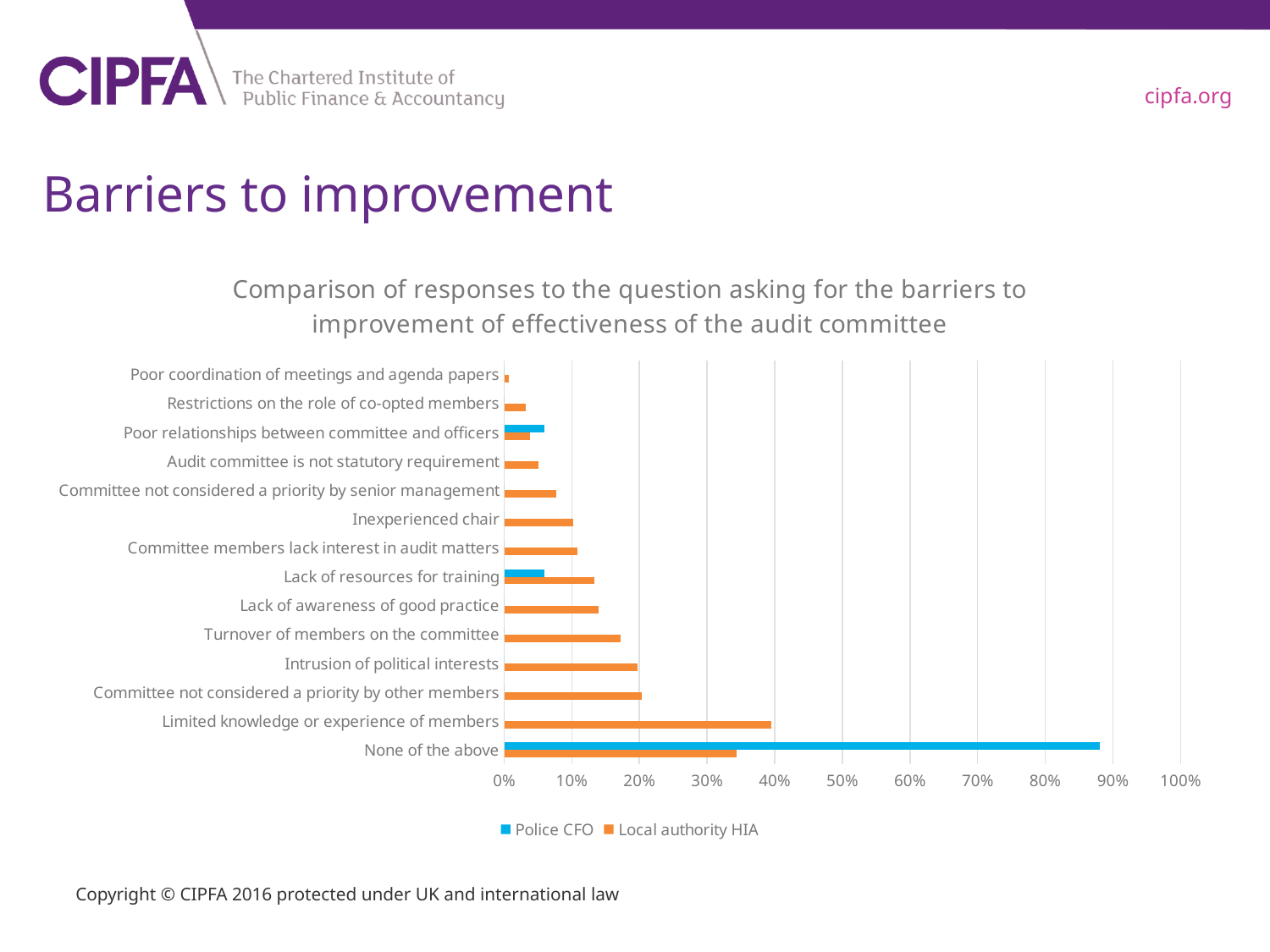
Which category has the lowest value for Local authority HIA? Poor coordination of meetings and agenda papers Which colour represents the Local authority HIA series in the legend? Orange Which category has the highest value for Police CFO? None of the above Is the Local authority HIA value for Turnover of members on the committee greater or less than 20%? less For Lack of resources for training, which series has the larger value, Police CFO or Local authority HIA? Local authority HIA Which category has the highest value for Local authority HIA? Limited knowledge or experience of members How many series does the legend list? 2 Is the Local authority HIA value for Limited knowledge or experience of members greater or less than 30%? greater How many categories are plotted on the chart? 14 For None of the above, which series has the larger value, Police CFO or Local authority HIA? Police CFO What kind of chart is shown on the slide? Bar chart Is the Police CFO value for None of the above greater or less than 80%? greater